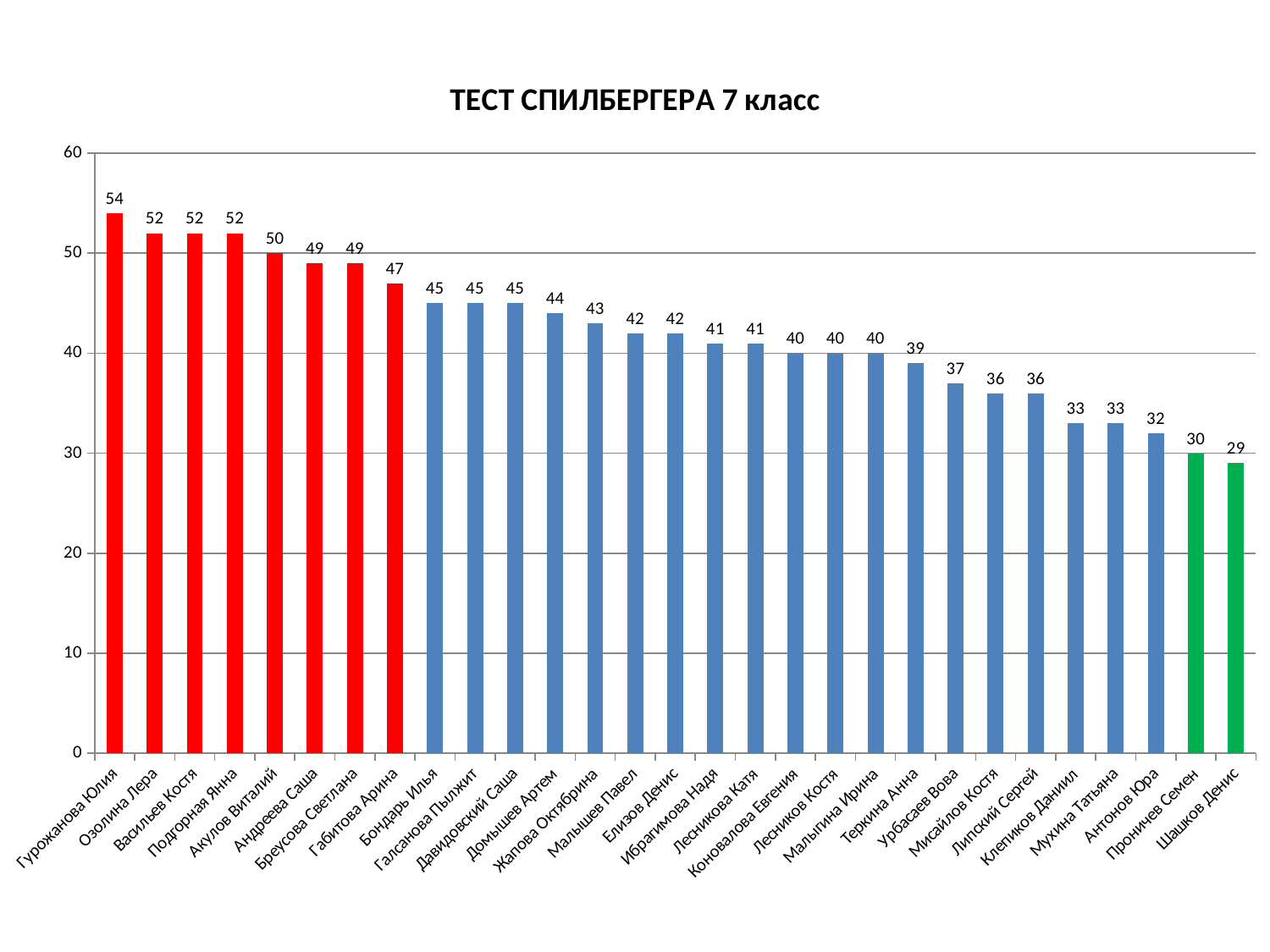
Which student has the highest value? Гурожанова Юлия Is the value for Урбасаев Вова greater or less than 40? less What is the difference between the values for Гурожанова Юлия and Шашков Денис? 25 What is the difference between the values for Акулов Виталий and Теркина Анна? 11 What is the value for Гурожанова Юлия? 54 Which student has the lowest value? Шашков Денис What is the title of the chart? ТЕСТ СПИЛБЕРГЕРА 7 класс What kind of chart is shown on the slide? bar chart How many students are shown on the chart? 29 What is the value for Проничев Семен? 30 Which is larger, the value for Габитова Арина or the value for Бондарь Илья? Габитова Арина What is the value for Жапова Октябрина? 43